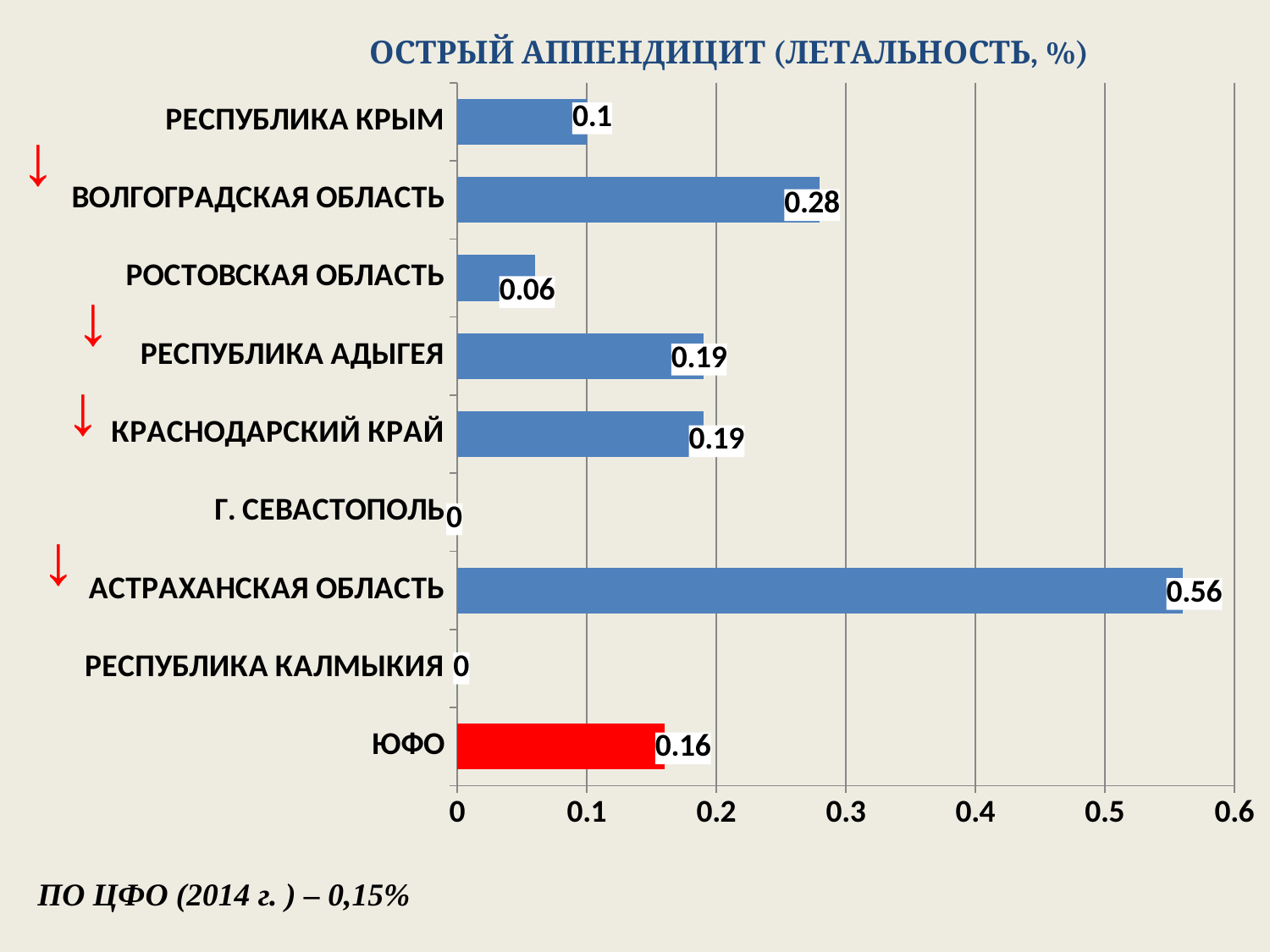
What is the value for Ростовская область? 0.06 Which category has the highest value? Астраханская область What kind of chart is shown on the slide? Bar chart Which category's bar is coloured red? ЮФО What is the value for Астраханская область? 0.56 What is the title of the chart? ОСТРЫЙ АППЕНДИЦИТ (ЛЕТАЛЬНОСТЬ, %) What is the difference between the values for Республика Крым and Ростовская область? 0.04 What is the value for ЮФО? 0.16 What is the difference between the values for Астраханская область and Волгоградская область? 0.28 Which is larger, the value for Республика Адыгея or the value for Республика Крым? Республика Адыгея What is the value for Волгоградская область? 0.28 How many categories are shown on the chart? 9